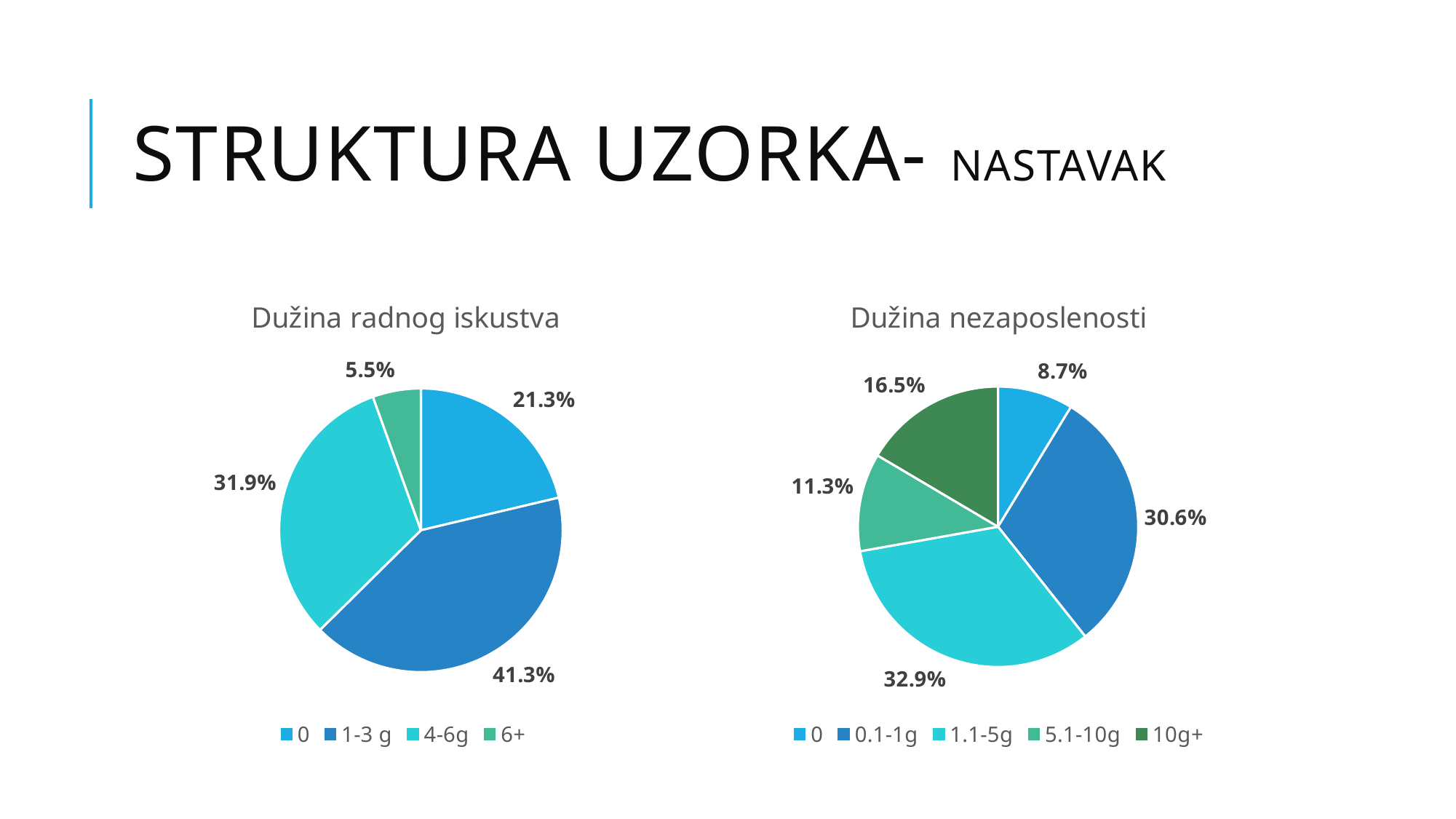
In the 'Dužina nezaposlenosti' chart, which is larger, '5.1-10g' or '10g+'? 10g+ In the 'Dužina radnog iskustva' chart, which category has the smallest slice? 6+ In the 'Dužina radnog iskustva' chart, what share does the '1-3 g' slice have? 41.3% In the 'Dužina radnog iskustva' chart, what is the difference between the '4-6g' and '0' slices? 10.6% In the 'Dužina radnog iskustva' chart, what is the value for '6+'? 5.5% In the 'Dužina nezaposlenosti' chart, how many categories are shown? 5 In the 'Dužina nezaposlenosti' chart, which category has the smallest slice? 0 In the 'Dužina radnog iskustva' chart, which category has the largest slice? 1-3 g What type of chart is used for 'Dužina nezaposlenosti'? Pie chart In the 'Dužina nezaposlenosti' chart, what is the value for '10g+'? 16.5% In the 'Dužina radnog iskustva' chart, how many categories does the legend list? 4 In the 'Dužina nezaposlenosti' chart, what is the value for '0.1-1g'? 30.6%